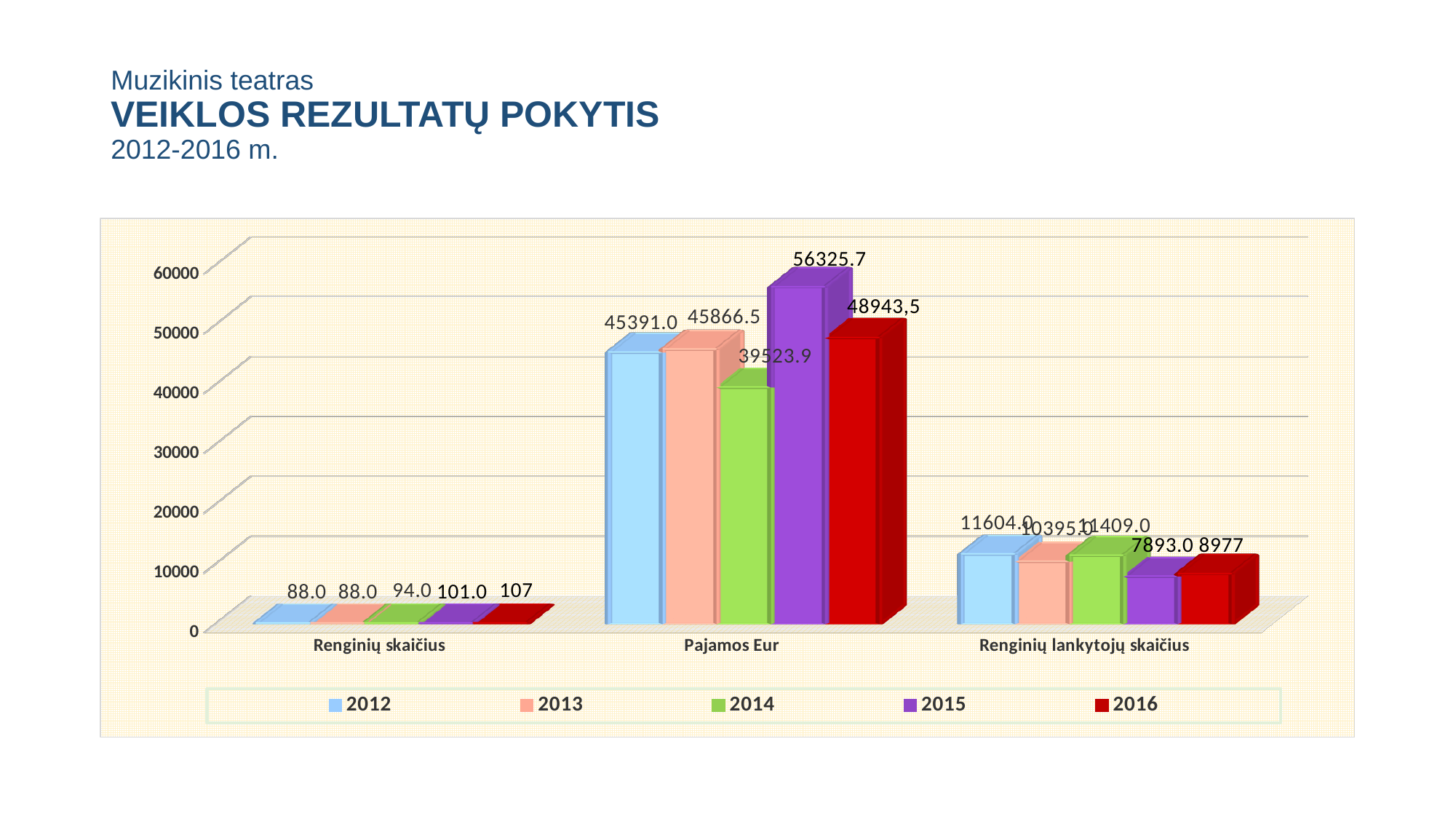
Which colour represents the 2014 series in the legend? green What is the difference between the 2016 and 2012 values in the Renginių skaičius category? 19 What is the value for 2015 in the Pajamos Eur category? 56325.7 Which year has the highest value in the Pajamos Eur category? 2015 What kind of chart is shown on the slide? bar chart Do the values in the Renginių skaičius category rise or fall from 2012 to 2016? rise Which year has the lowest value in the Renginių lankytojų skaičius category? 2015 How many series does the legend list? 5 What is the value for 2016 in the Renginių skaičius category? 107 In the Pajamos Eur category, which is larger: the value for 2013 or the value for 2014? 2013 What is the value for 2013 in the Renginių lankytojų skaičius category? 10395.0 How many categories are shown on the x axis? 3